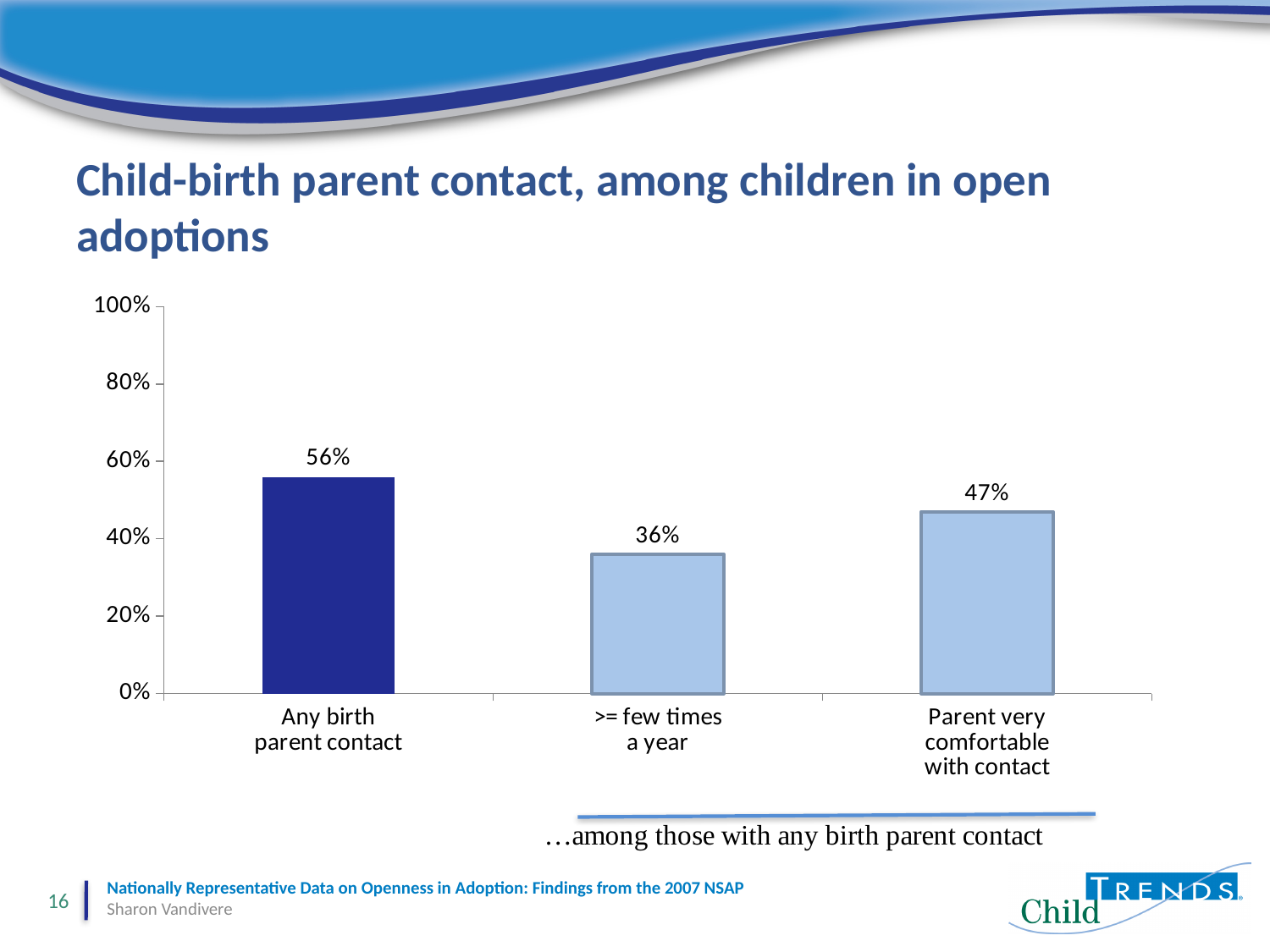
Which category has the lowest value? >= few times a year What is the value for 'Any birth parent contact'? 56% What is the title of the chart on the slide? Child-birth parent contact, among children in open adoptions Is the value for 'Any birth parent contact' greater or less than 60%? less What is the value for 'Parent very comfortable with contact'? 47% How many categories are shown in the chart? 3 What is the difference between the values for 'Any birth parent contact' and '>= few times a year'? 20% What kind of chart is shown on the slide? Bar chart Which category has the highest value? Any birth parent contact What is the difference between the values for 'Parent very comfortable with contact' and '>= few times a year'? 11% Which is larger, the value for 'Parent very comfortable with contact' or the value for '>= few times a year'? Parent very comfortable with contact What is the value for '>= few times a year'? 36%